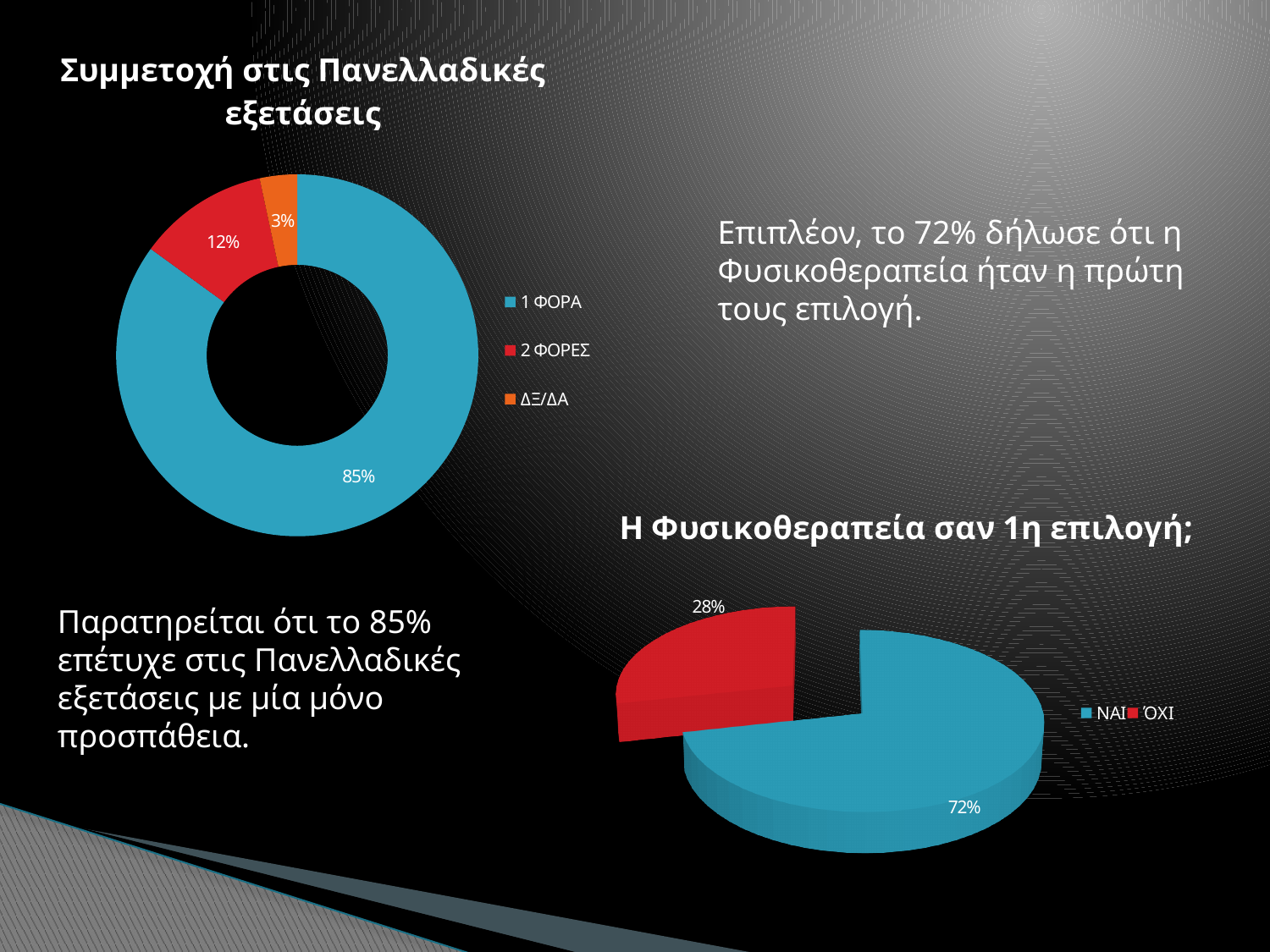
In the chart titled "Η Φυσικοθεραπεία σαν 1η επιλογή;", what percentage is shown for "ΝΑΙ"? 72% In the chart titled "Συμμετοχή στις Πανελλαδικές εξετάσεις", which category has the largest share? 1 ΦΟΡΑ In the chart titled "Συμμετοχή στις Πανελλαδικές εξετάσεις", what is the difference in percentage points between "1 ΦΟΡΑ" and "2 ΦΟΡΕΣ"? 73 In the chart titled "Η Φυσικοθεραπεία σαν 1η επιλογή;", what is the difference in percentage points between "ΝΑΙ" and "ΌΧΙ"? 44 In the chart titled "Συμμετοχή στις Πανελλαδικές εξετάσεις", how many categories does the legend list? 3 In the chart titled "Η Φυσικοθεραπεία σαν 1η επιλογή;", what percentage is shown for "ΌΧΙ"? 28% In the chart titled "Η Φυσικοθεραπεία σαν 1η επιλογή;", which is larger, "ΝΑΙ" or "ΌΧΙ"? ΝΑΙ In the chart titled "Συμμετοχή στις Πανελλαδικές εξετάσεις", what percentage is shown for "2 ΦΟΡΕΣ"? 12% In the chart titled "Συμμετοχή στις Πανελλαδικές εξετάσεις", what percentage is shown for "1 ΦΟΡΑ"? 85% In the chart titled "Συμμετοχή στις Πανελλαδικές εξετάσεις", which category has the smallest share? ΔΞ/ΔΑ In the chart titled "Συμμετοχή στις Πανελλαδικές εξετάσεις", what percentage is shown for "ΔΞ/ΔΑ"? 3% What type of chart is the one titled "Η Φυσικοθεραπεία σαν 1η επιλογή;"? Pie chart